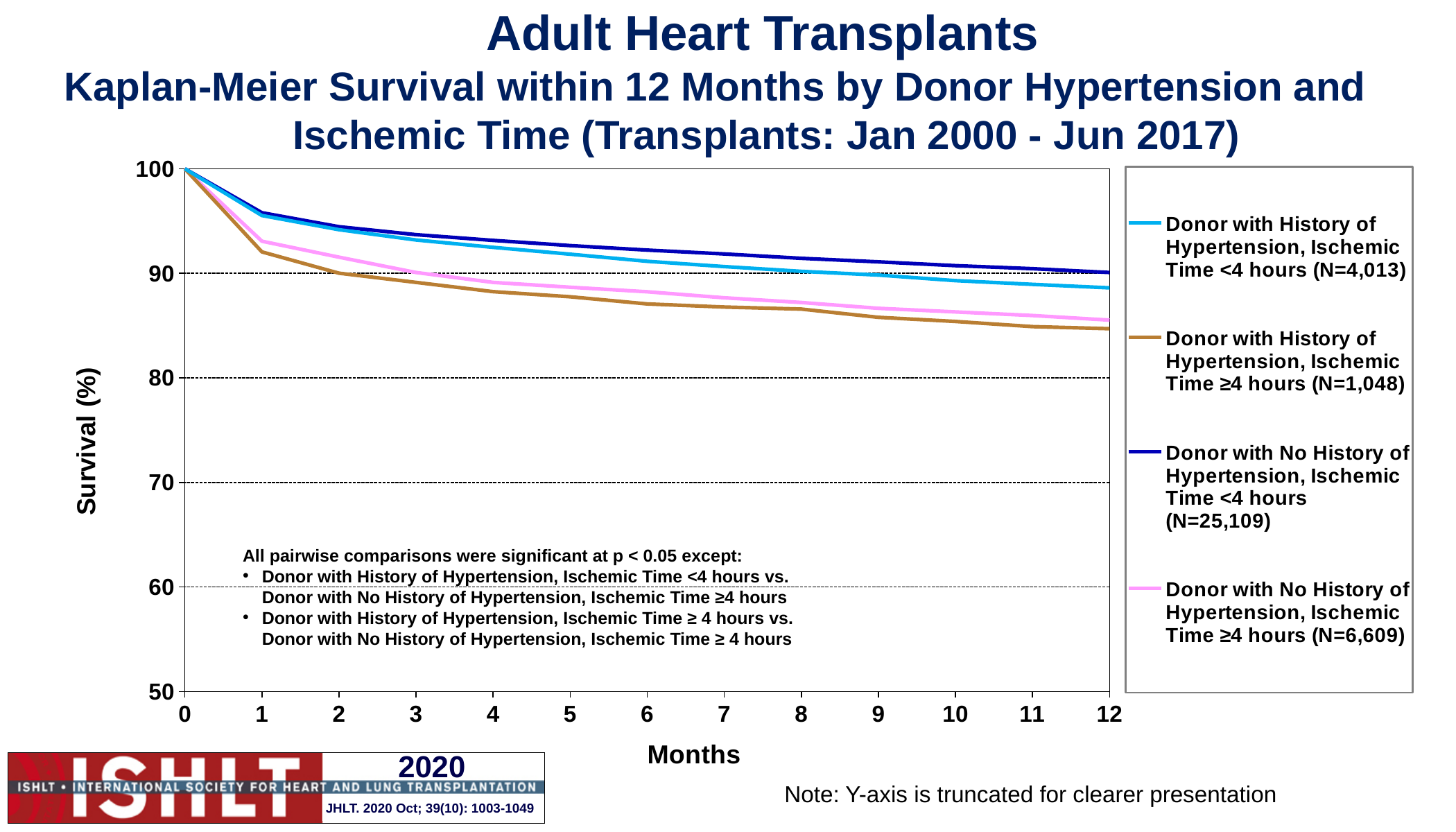
What is the label of the y axis? Survival (%) At 12 months, which group has higher survival: Donor with History of Hypertension, Ischemic Time <4 hours or Donor with No History of Hypertension, Ischemic Time ≥4 hours? Donor with History of Hypertension, Ischemic Time <4 hours What is the survival value for all four groups at month 0? 100 What is the sample size (N) for the Donor with No History of Hypertension, Ischemic Time <4 hours group? 25,109 Which group has the lowest survival at 12 months? Donor with History of Hypertension, Ischemic Time ≥4 hours Is the survival value for Donor with History of Hypertension, Ischemic Time ≥4 hours at 1 month greater or less than 90? greater What kind of chart is shown on the slide? Line chart Do the survival curves rise or fall as months increase along the x axis? Fall Is the survival value for Donor with History of Hypertension, Ischemic Time ≥4 hours at 12 months greater or less than 90? less Which group has the highest survival at 12 months? Donor with No History of Hypertension, Ischemic Time <4 hours How many series does the legend list? 4 Is the survival value for Donor with No History of Hypertension, Ischemic Time ≥4 hours at 6 months greater or less than 80? greater